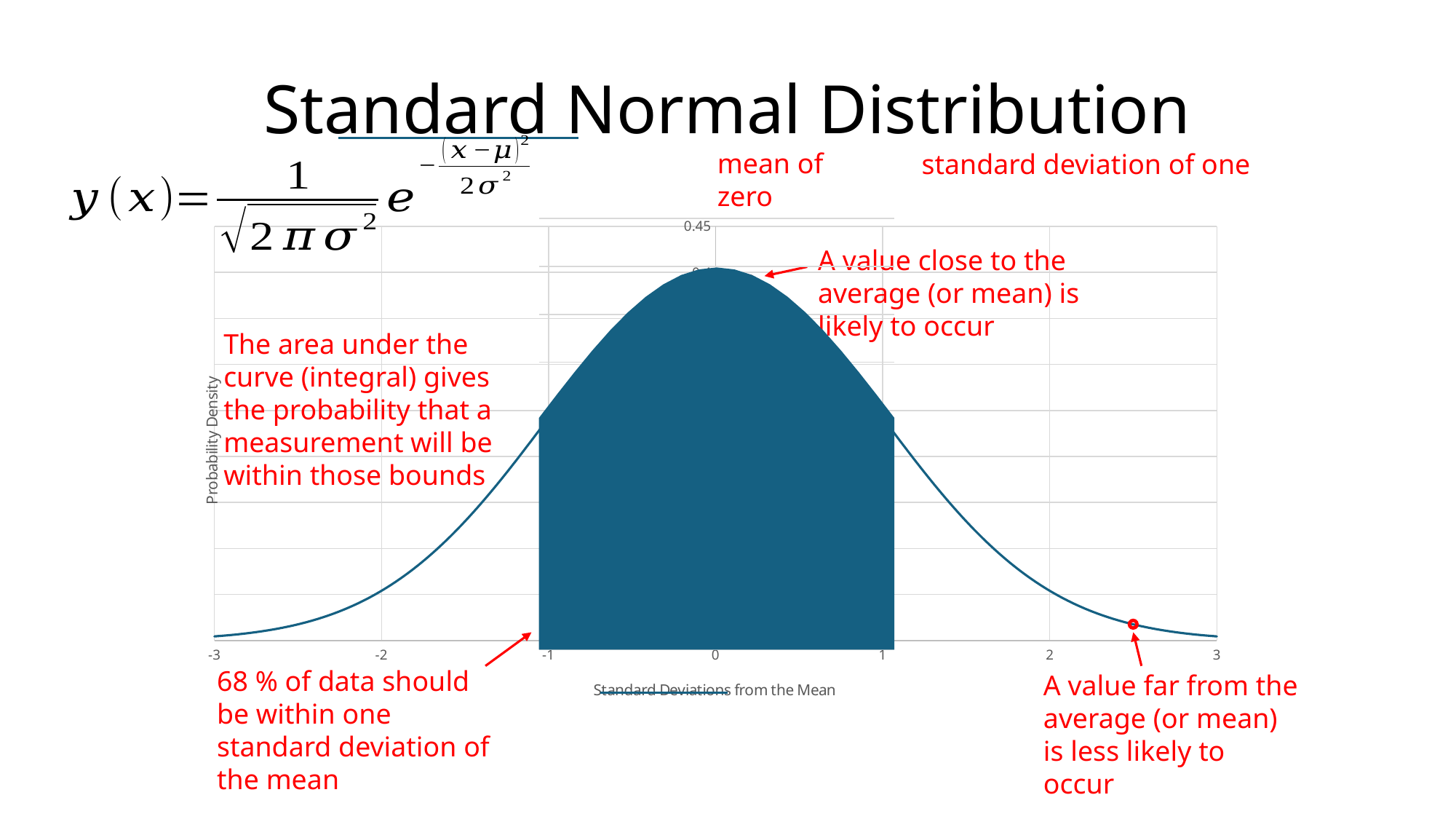
Does the curve rise or fall as x goes from 0 to 3? fall Is the peak value of the curve greater or less than 0.45? less At which x-axis value does the curve reach its highest point? 0 Between which two x-axis values is the area under the curve shaded? -1 and 1 What is the label of the x axis of the chart? Standard Deviations from the Mean What is the lowest value shown on the x axis? -3 Which has the larger probability density, x = -3 or x = -1? -1 What is the label of the y axis of the chart? Probability Density Which has the larger probability density, x = 0 or x = 2? 0 What kind of chart is shown on the slide? line chart How many tick labels are shown on the x axis? 7 Does the curve rise or fall as x goes from -3 to 0? rise